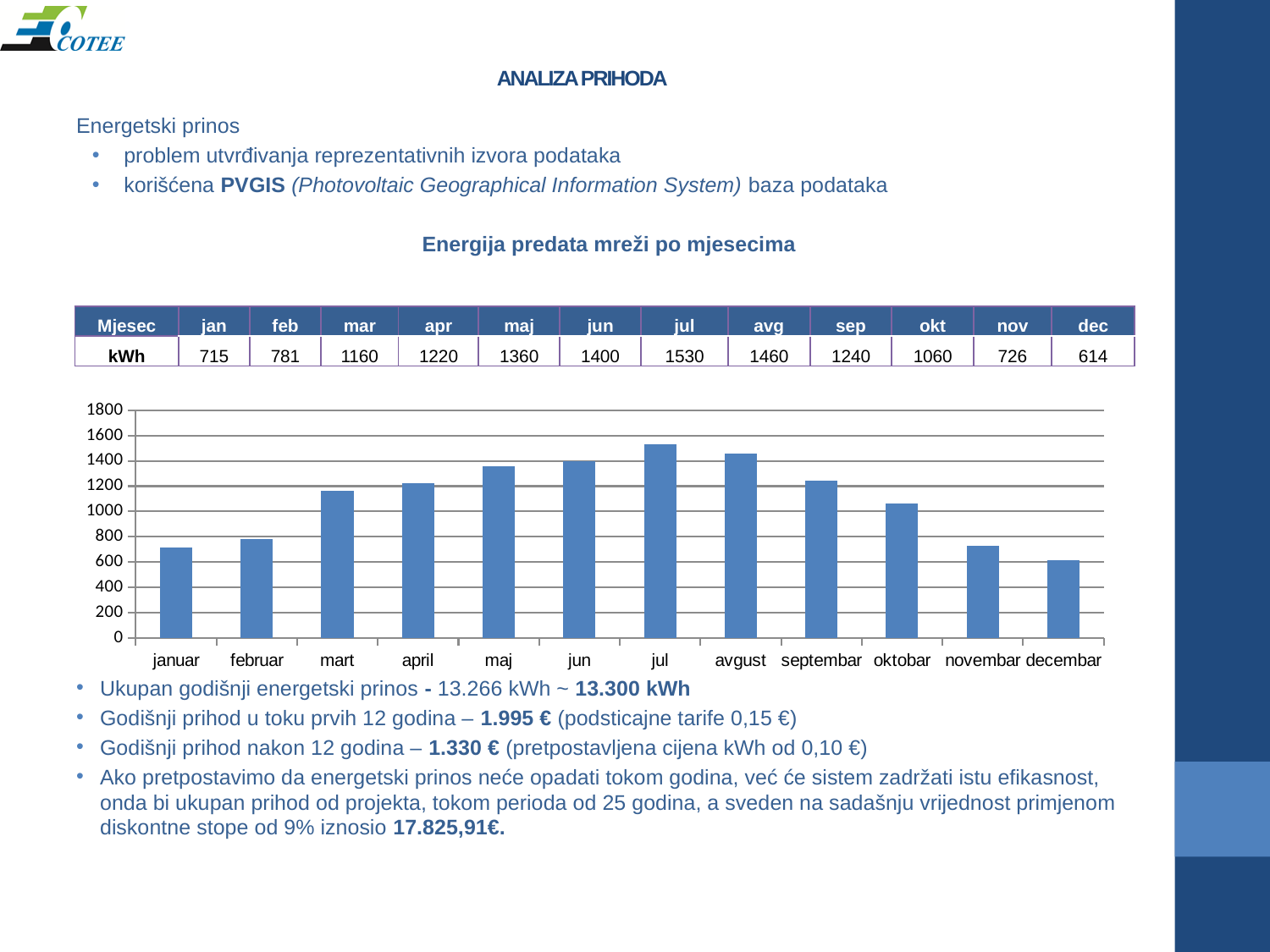
Is the value for avgust greater or less than 1400? greater What is the kWh value for januar according to the table above the chart? 715 What is the kWh value for jul according to the table above the chart? 1530 What is the difference in kWh between jul and decembar? 916 Which month has the highest energy value in the chart? jul What is the title of the chart? Energija predata mreži po mjesecima Do the values rise or fall from januar to jul? rise What kind of chart is shown on the slide? bar chart Which month has the lowest energy value in the chart? decembar Is the value for novembar greater or less than 800? less How many months (categories) are plotted in the chart? 12 Which is larger, the value for mart or the value for oktobar? mart